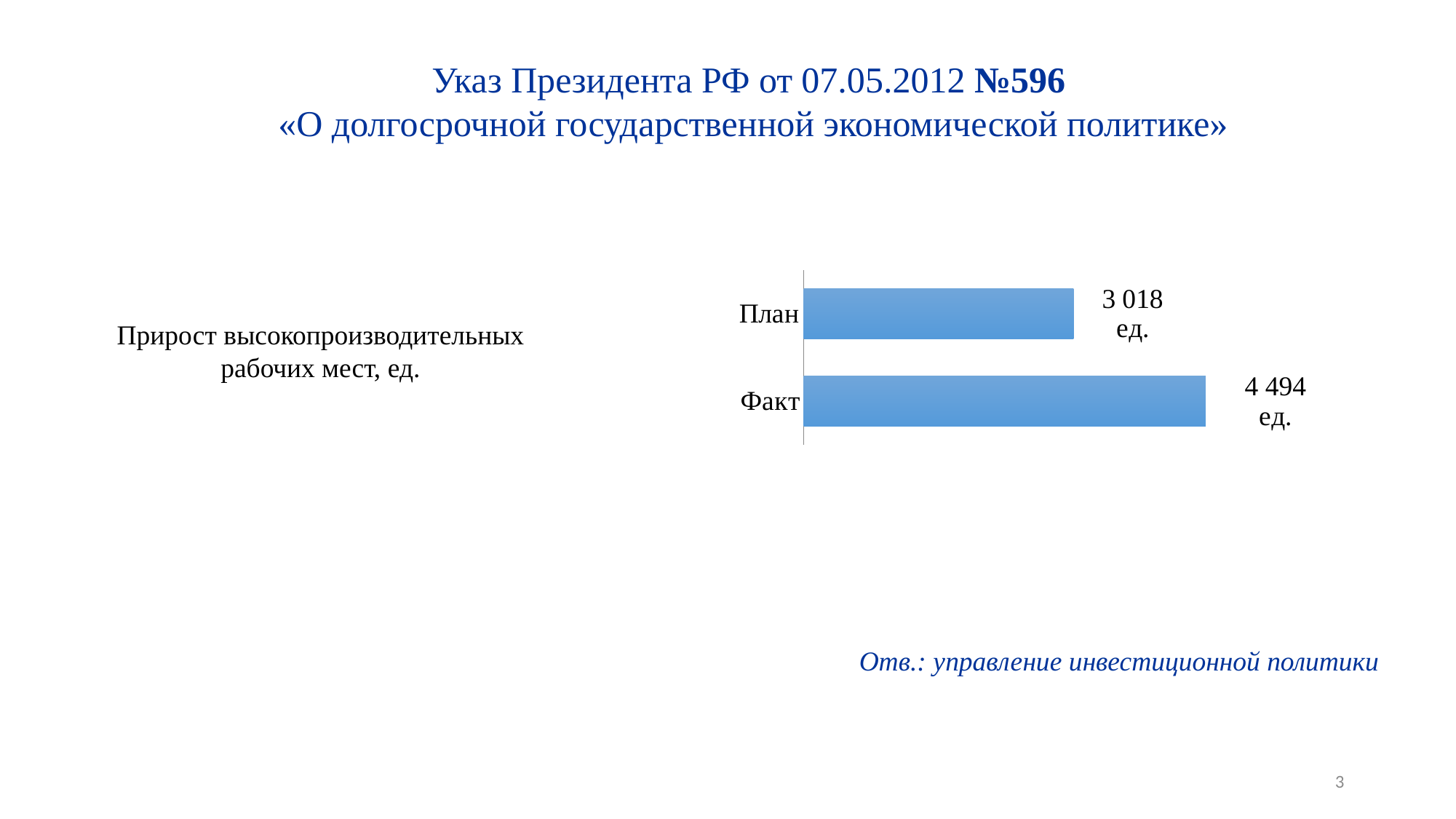
What is the value for Факт (Fact)? 4 494 ед. What colour are the bars in the chart? blue What type of chart is shown on the slide? bar chart Which category has the lower value? План What indicator does the chart show, according to the text to its left? Прирост высокопроизводительных рабочих мест, ед. What is the difference between the Факт and План values? 1 476 ед. How many bars are shown in the chart? 2 Is the value for Факт larger or smaller than the value for План? larger Which category has the higher value, План or Факт? Факт What is the value for План (Plan)? 3 018 ед.